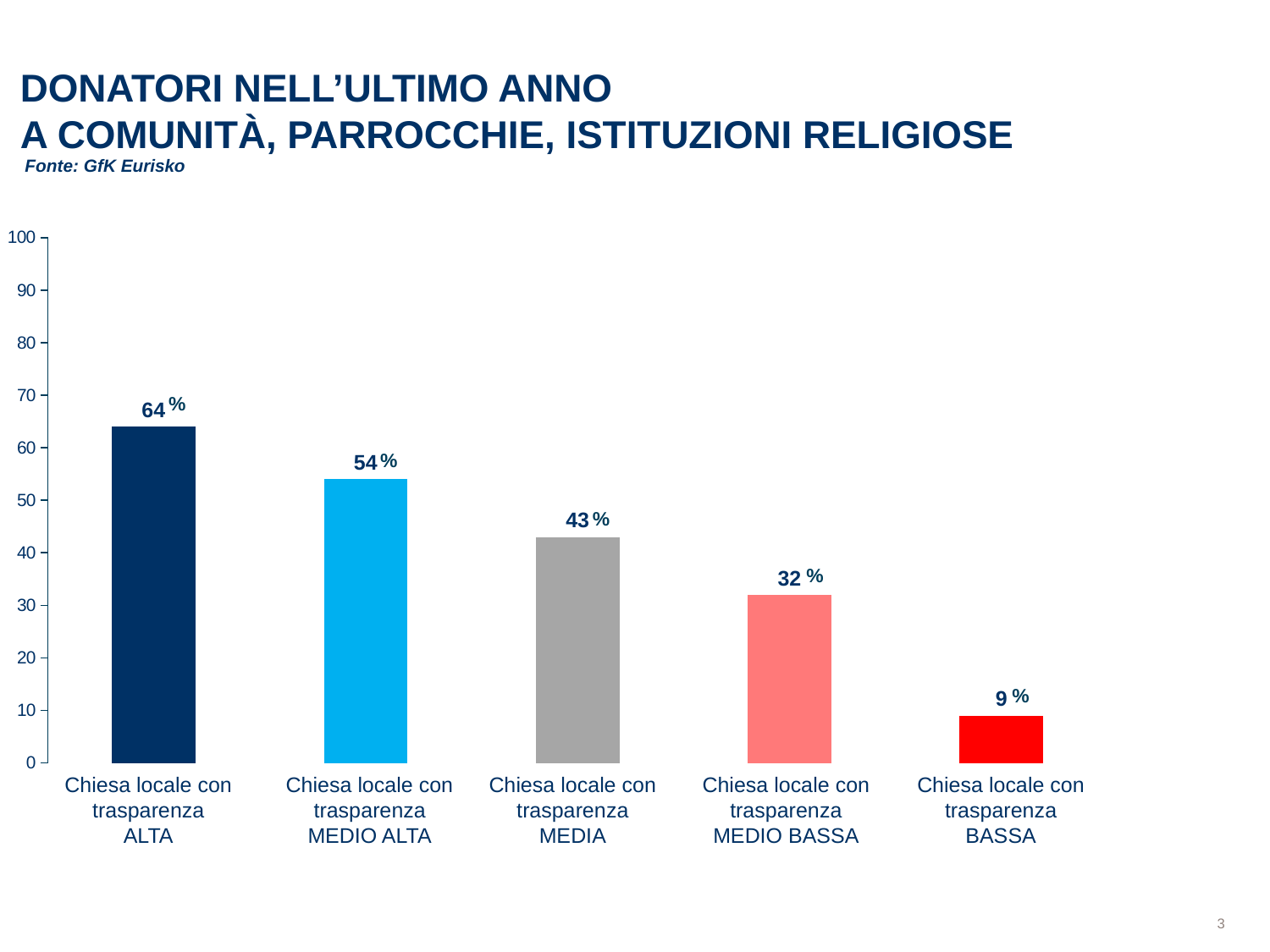
What is the difference between the values for 'Chiesa locale con trasparenza ALTA' and 'Chiesa locale con trasparenza MEDIO ALTA'? 10% Which is larger: the value for 'Chiesa locale con trasparenza MEDIA' or for 'Chiesa locale con trasparenza MEDIO BASSA'? Chiesa locale con trasparenza MEDIA How many categories are shown in the chart? 5 What kind of chart is shown on the slide? bar chart Do the values rise or fall from left to right along the x axis? fall What is the value for 'Chiesa locale con trasparenza BASSA'? 9% Which category has the highest value? Chiesa locale con trasparenza ALTA Is the value for 'Chiesa locale con trasparenza MEDIO ALTA' greater or less than 50? greater What is the value for 'Chiesa locale con trasparenza ALTA'? 64% What is the difference between the values for 'Chiesa locale con trasparenza MEDIA' and 'Chiesa locale con trasparenza BASSA'? 34% What is the value for 'Chiesa locale con trasparenza MEDIO BASSA'? 32% Which category has the lowest value? Chiesa locale con trasparenza BASSA